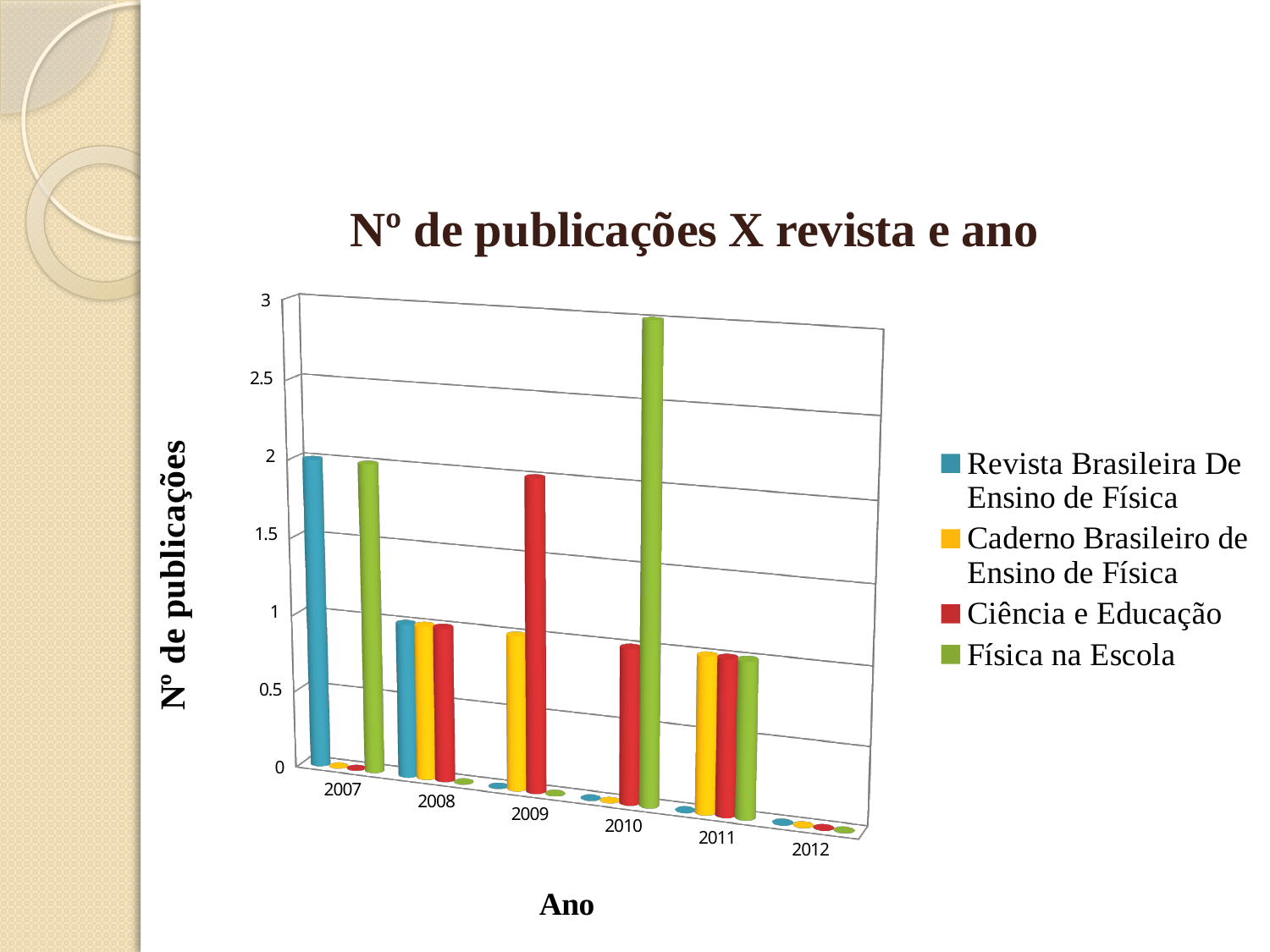
What is the title of the chart? Nº de publicações X revista e ano Is the value for Ciência e Educação in 2009 greater or less than 1.5? greater Is the value for Física na Escola in 2010 greater or less than 2? greater Which is larger: Física na Escola in 2010 or Ciência e Educação in 2009? Física na Escola in 2010 How many years are shown on the x axis? 6 In which year do all four series show no publications? 2012 Which is larger: Revista Brasileira De Ensino de Física in 2007 or in 2008? 2007 Is the value for Revista Brasileira De Ensino de Física in 2007 greater or less than 1.5? greater How many series does the legend list? 4 Which series and year has the highest bar in the chart? Física na Escola in 2010 What kind of chart is shown on the slide? bar chart